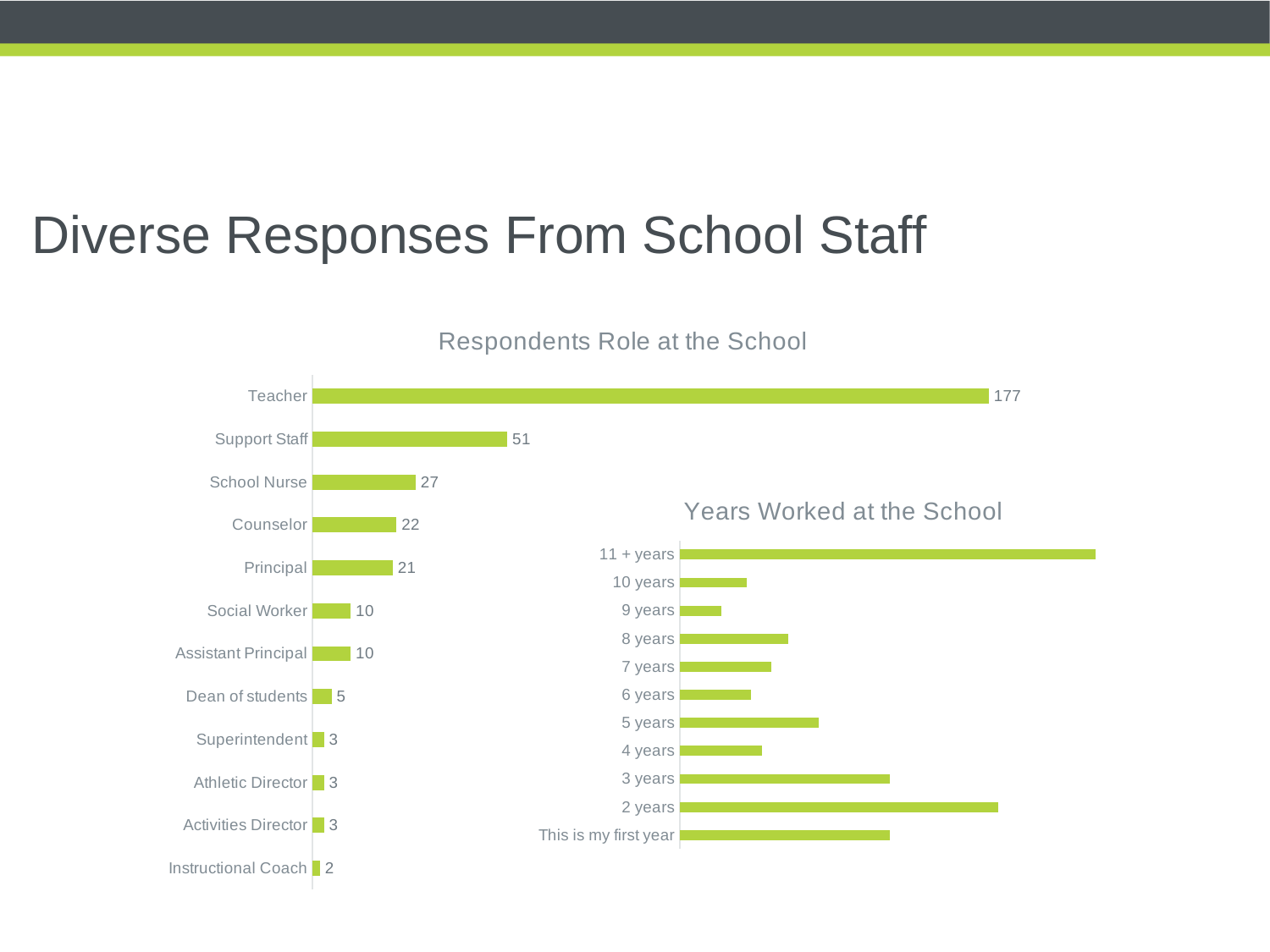
In the 'Respondents Role at the School' chart, how many roles are listed? 12 What kind of chart is 'Respondents Role at the School'? Bar chart In the 'Years Worked at the School' chart, how many categories are shown? 11 In the 'Respondents Role at the School' chart, how many respondents are Teachers? 177 In the 'Years Worked at the School' chart, which category has the longest bar? 11 + years In the 'Respondents Role at the School' chart, what is the value for School Nurse? 27 In the 'Years Worked at the School' chart, which is larger, 2 years or 3 years? 2 years In the 'Respondents Role at the School' chart, which role has the highest number of respondents? Teacher In the 'Respondents Role at the School' chart, what is the difference between Support Staff and Counselor? 29 In the 'Respondents Role at the School' chart, which is larger, Principal or Social Worker? Principal In the 'Respondents Role at the School' chart, which role has the lowest number of respondents? Instructional Coach In the 'Years Worked at the School' chart, which category has the shortest bar? 9 years